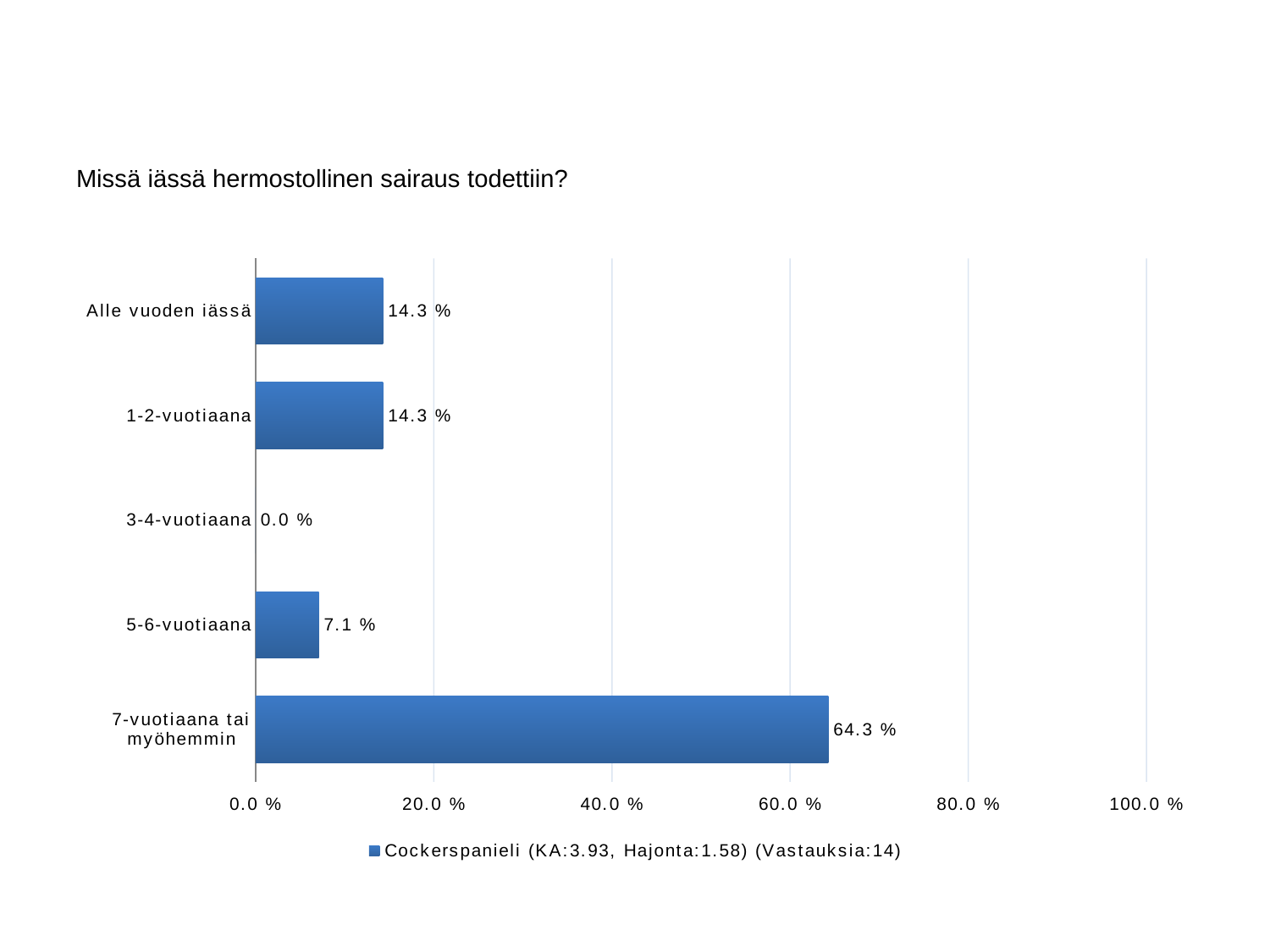
What is the title of the chart? Missä iässä hermostollinen sairaus todettiin? What kind of chart is shown on the slide? bar chart What is the value for "Alle vuoden iässä"? 14.3 % What is the difference between the values for "7-vuotiaana tai myöhemmin" and "5-6-vuotiaana"? 57.2 % What is the value for "7-vuotiaana tai myöhemmin"? 64.3 % What is the value for "5-6-vuotiaana"? 7.1 % Which category has the highest value? 7-vuotiaana tai myöhemmin Which is larger, the value for "1-2-vuotiaana" or the value for "5-6-vuotiaana"? 1-2-vuotiaana Which category has the lowest value? 3-4-vuotiaana How many categories are shown on the chart? 5 What is the value for "3-4-vuotiaana"? 0.0 % Is the value for "7-vuotiaana tai myöhemmin" greater or less than 60.0 %? greater